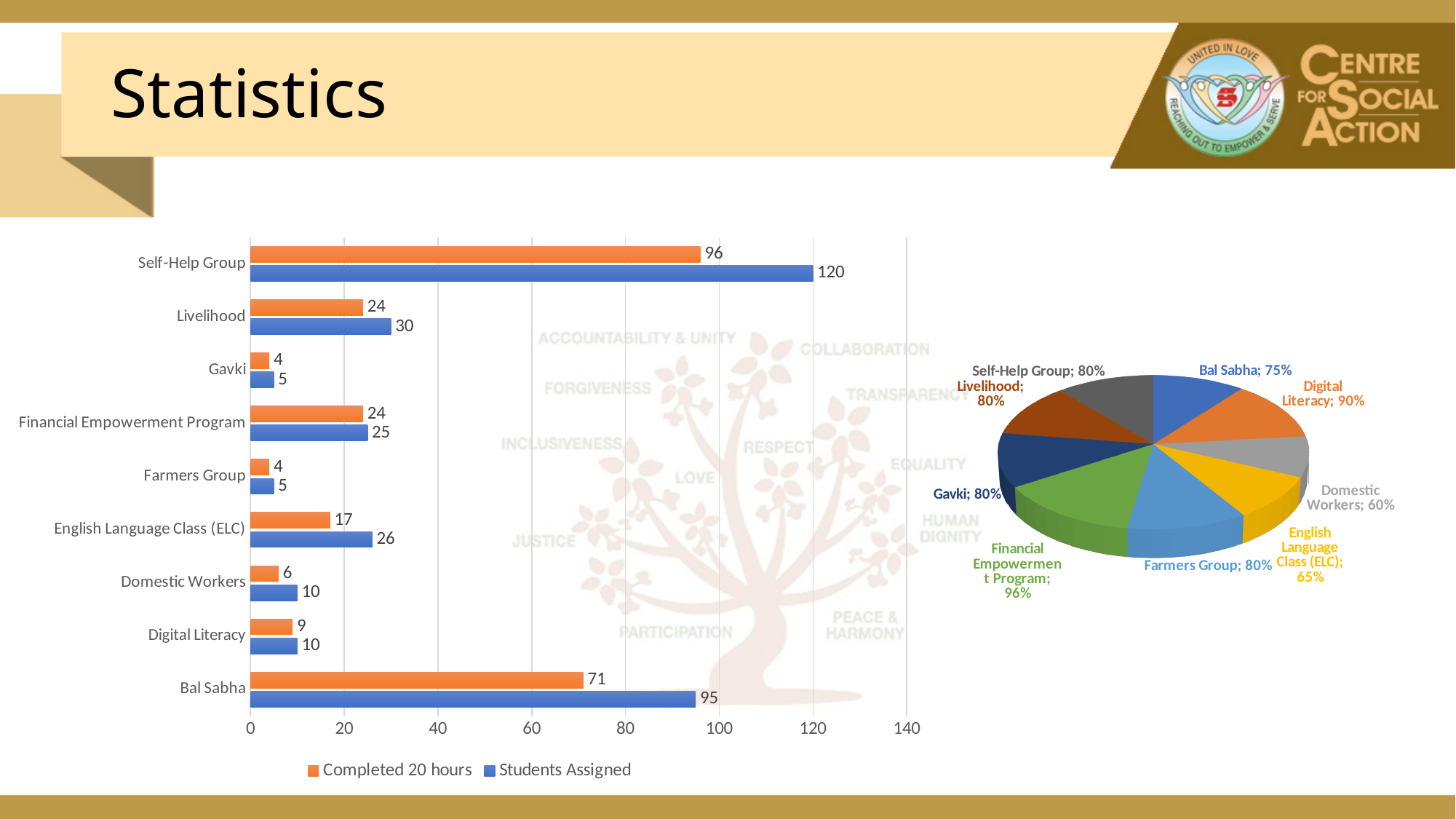
In the bar chart on the left, is the Completed 20 hours value for Self-Help Group greater or less than 80? greater In the bar chart on the left, what is the Completed 20 hours value for Bal Sabha? 71 In the pie chart on the right, which category has the lowest percentage? Domestic Workers In the bar chart on the left, which is larger: Students Assigned for Livelihood or Students Assigned for Financial Empowerment Program? Livelihood What are the two series named in the legend of the bar chart on the left? Completed 20 hours and Students Assigned In the bar chart on the left, which category has the highest Students Assigned value? Self-Help Group How many series does the legend of the bar chart on the left list? 2 In the bar chart on the left, what is the difference between Students Assigned and Completed 20 hours for English Language Class (ELC)? 9 What kind of chart is the chart on the left of the slide? Bar chart How many categories does the bar chart on the left show? 9 In the pie chart on the right, what percentage is shown for Digital Literacy? 90% In the bar chart on the left, how many Students Assigned are shown for Self-Help Group? 120